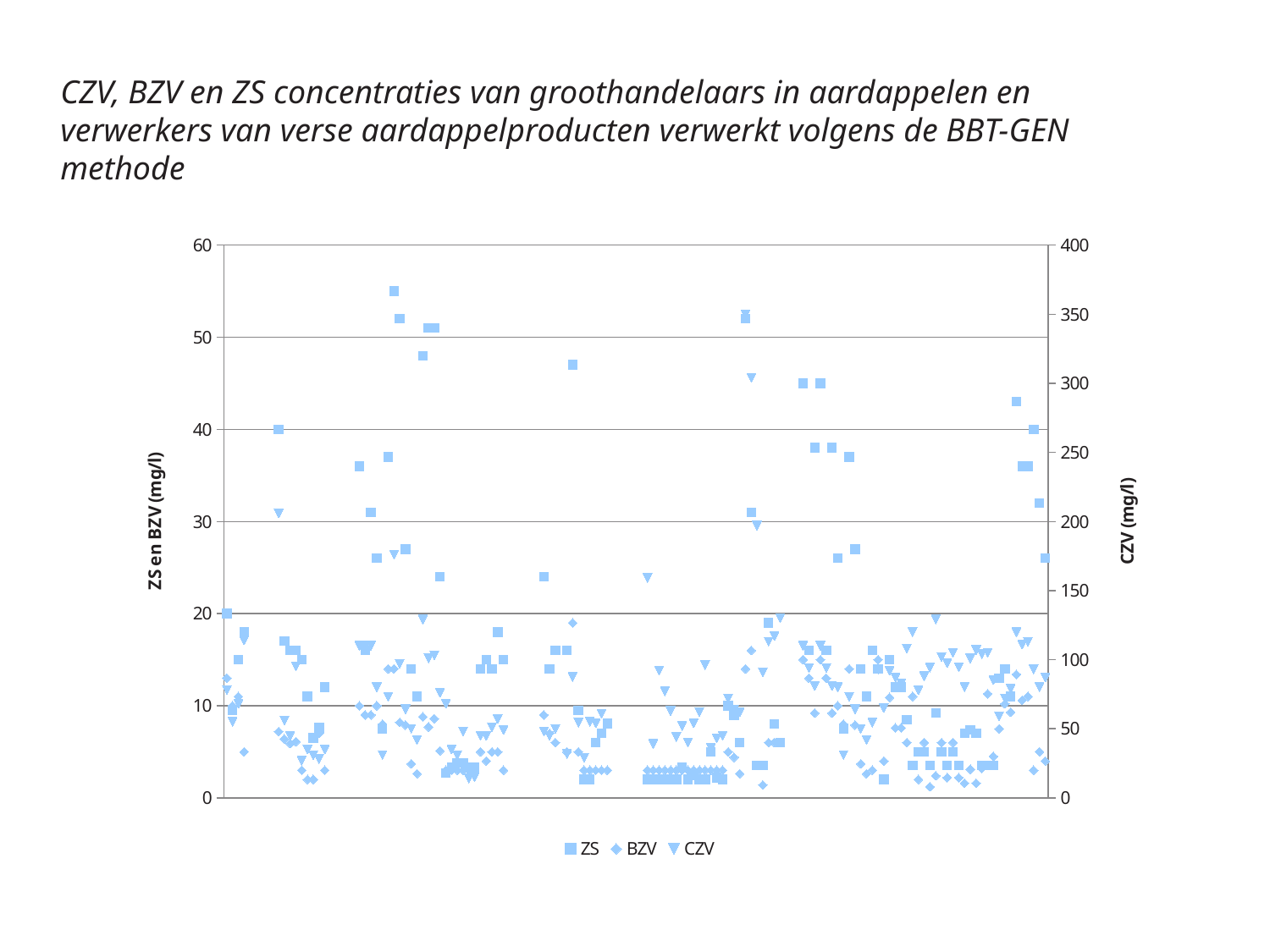
What is the maximum value shown on the left vertical axis? 60 Is the highest ZS value plotted greater or less than 50? greater Is the highest BZV value plotted greater or less than 30? less Which series reaches the highest value on the left axis, ZS or BZV? ZS How many series does the legend list? 3 What is the maximum value shown on the right vertical axis (CZV)? 400 What is the title of the left vertical axis? ZS en BZV (mg/l) Which series are listed in the legend? ZS, BZV, CZV What kind of chart is shown on the slide? scatter chart Is the highest CZV value plotted greater or less than 300 on the right axis? greater